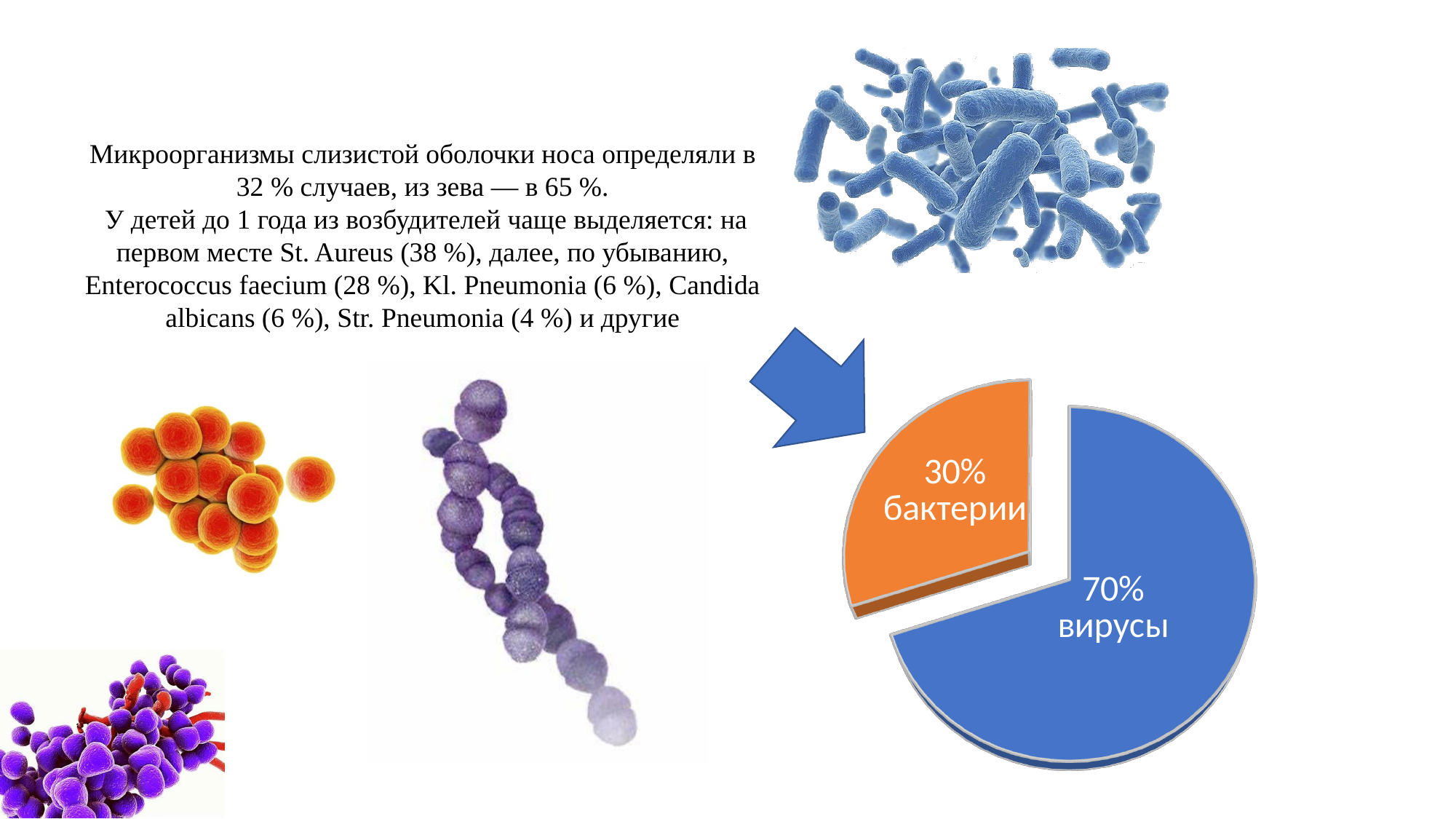
Is the share for бактерии greater or less than 50%? less What colour is the вирусы slice of the pie chart? blue Which slice of the pie chart is the smallest? бактерии What kind of chart is shown on the slide? pie chart How many slices does the pie chart have? 2 What colour is the бактерии slice of the pie chart? orange What share of the pie chart is labelled бактерии? 30% Which is larger in the pie chart, вирусы or бактерии? вирусы What share of the pie chart is labelled вирусы? 70% Which slice of the pie chart is the largest? вирусы What is the difference in percentage points between the вирусы slice and the бактерии slice? 40%